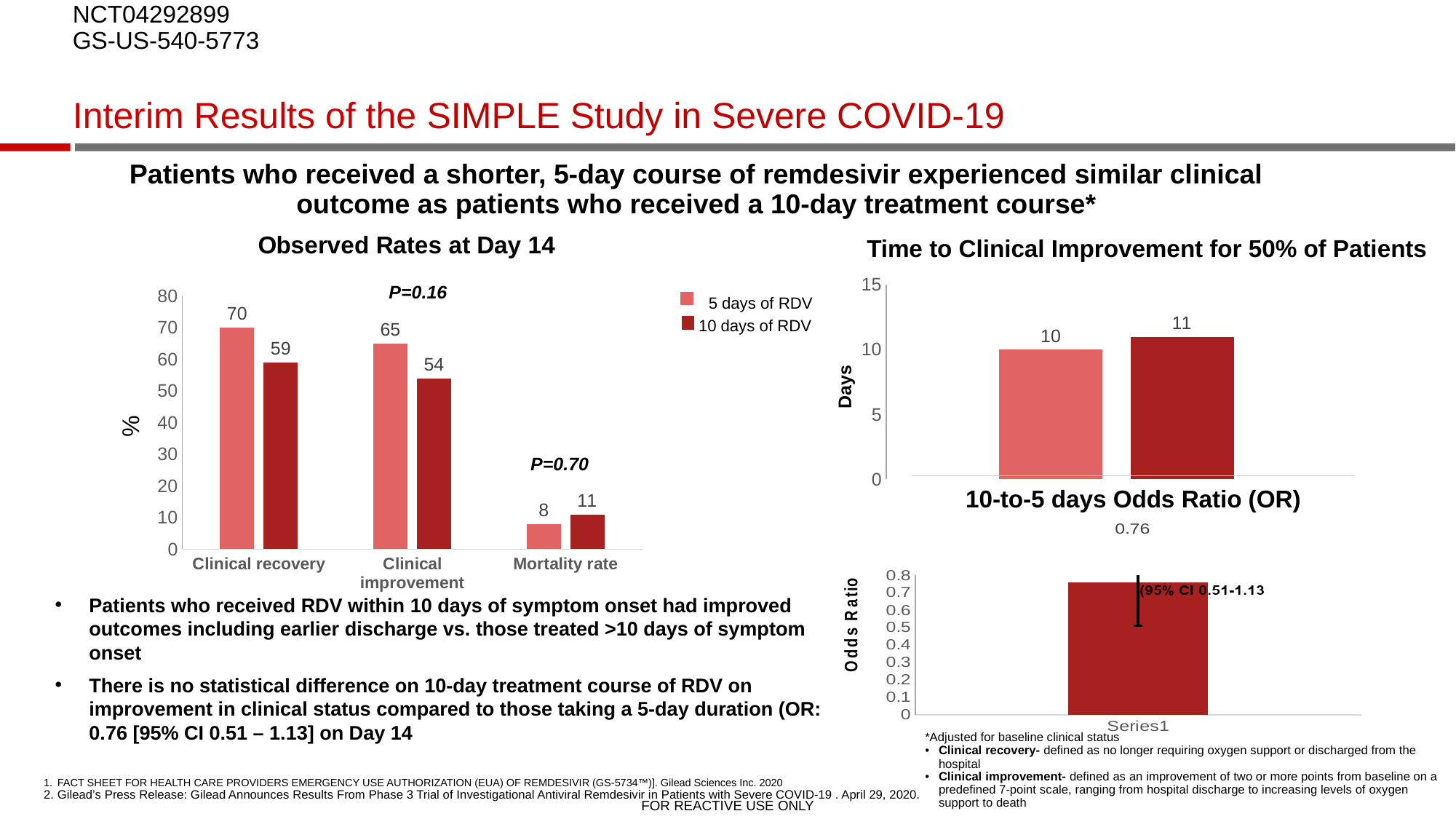
What is the y-axis label of the 'Time to Clinical Improvement for 50% of Patients' chart? Days In the '10-to-5 days Odds Ratio (OR)' chart, what is the value of the plotted bar? 0.76 What kind of chart is 'Observed Rates at Day 14'? Bar chart How many categories are shown on the x axis of the 'Observed Rates at Day 14' chart? 3 In the 'Time to Clinical Improvement for 50% of Patients' chart, what is the value for the 10 days of RDV bar? 11 In the 'Observed Rates at Day 14' chart, what is the mortality rate for 10 days of RDV? 11 In the 'Observed Rates at Day 14' chart, what is the clinical recovery rate for 5 days of RDV? 70 How many series does the legend of the 'Observed Rates at Day 14' chart list? 2 In the 'Observed Rates at Day 14' chart, which is larger for clinical recovery: 5 days of RDV or 10 days of RDV? 5 days of RDV In the 'Observed Rates at Day 14' chart, which category has the lowest value for 5 days of RDV? Mortality rate In the 'Observed Rates at Day 14' chart, what is the difference between the clinical improvement rates for 5 days and 10 days of RDV? 11 In the 'Time to Clinical Improvement for 50% of Patients' chart, what is the difference in days between the two bars? 1